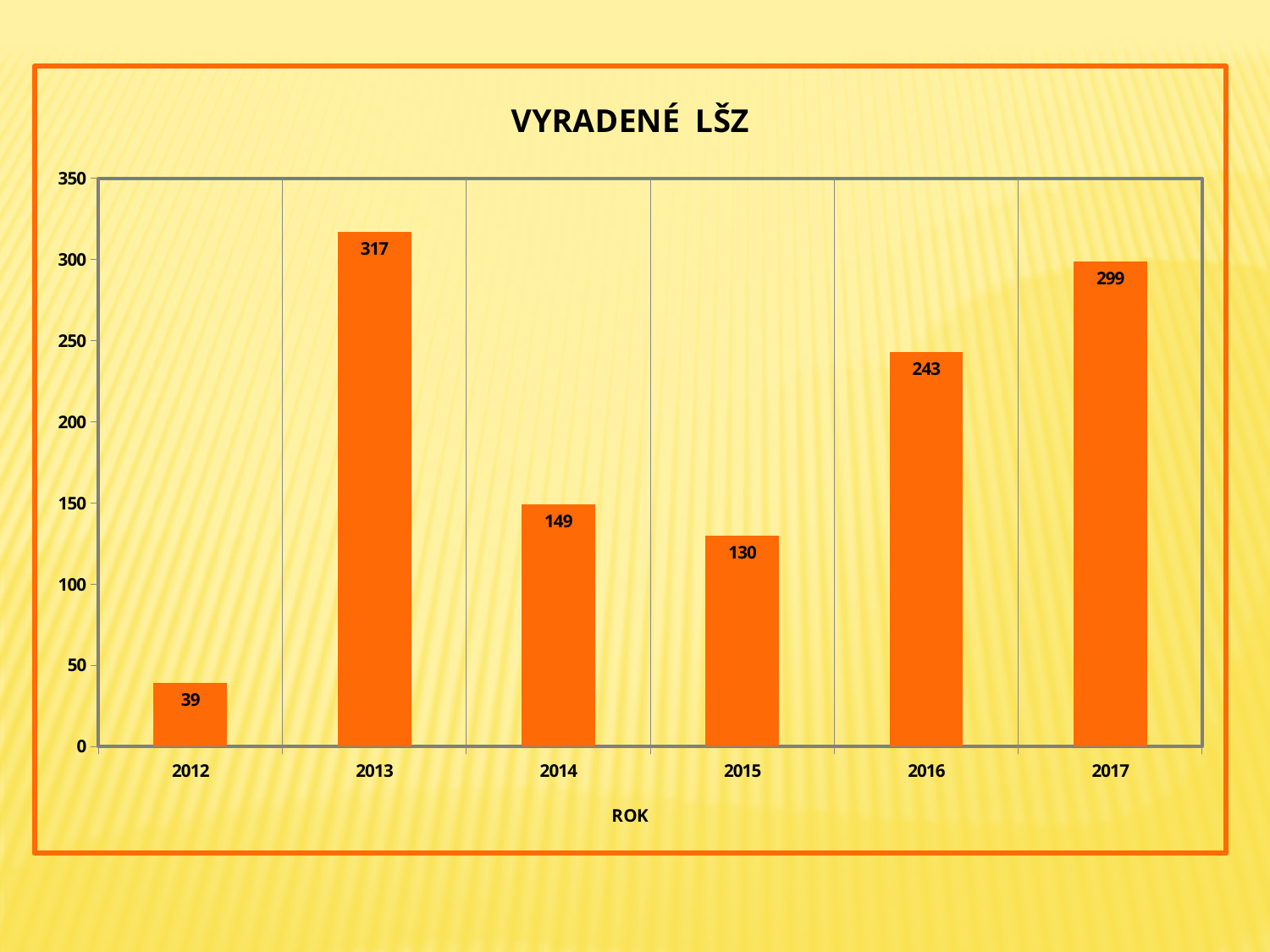
Which is larger, the value for 2014 or the value for 2015? 2014 What is the value for 2012? 39 What is the difference between the values for 2014 and 2015? 19 What is the difference between the values for 2017 and 2016? 56 How many years are shown on the x axis? 6 What kind of chart is shown on the slide? bar chart Which year has the highest value? 2013 What is the title of the chart? VYRADENÉ LŠZ What is the value for 2013? 317 Is the value for 2017 greater or less than 250? greater Which year has the lowest value? 2012 What is the value for 2016? 243